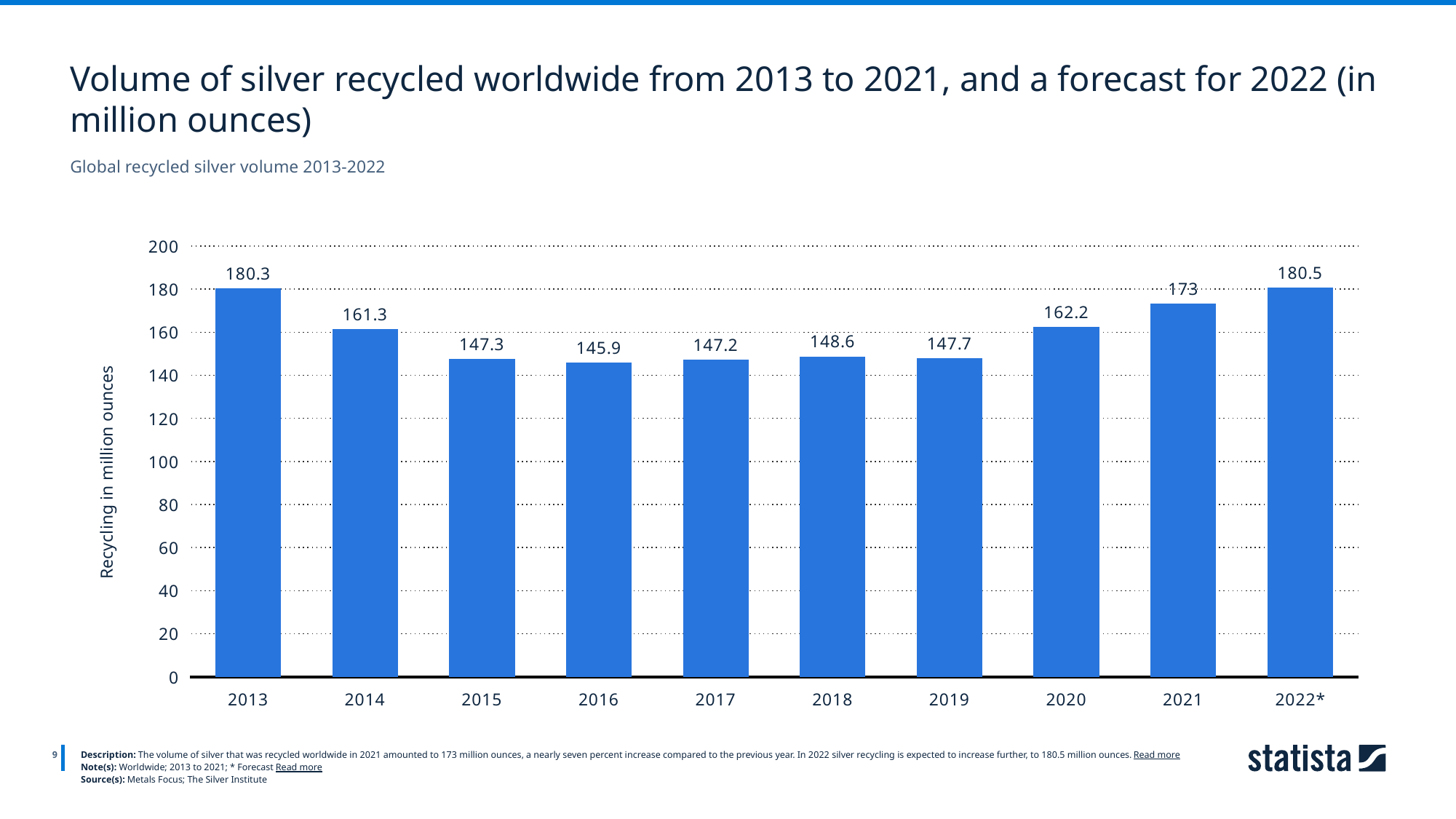
What was the volume of silver recycled worldwide in 2013? 180.3 What kind of chart is shown on the slide? Bar chart How many years are shown on the x axis of the chart? 10 What is the label of the y axis? Recycling in million ounces Which year had a larger recycled silver volume, 2013 or 2015? 2013 What was the volume of silver recycled worldwide in 2021? 173 Is the value for 2021 greater or less than 180? less What is the difference between the recycled silver volume in 2013 and in 2014? 19 What was the volume of silver recycled worldwide in 2016? 145.9 Is the value for 2018 greater or less than 140? greater What is the forecast volume of silver recycled worldwide for 2022? 180.5 By how much did the recycled silver volume increase from 2020 to 2021? 10.8